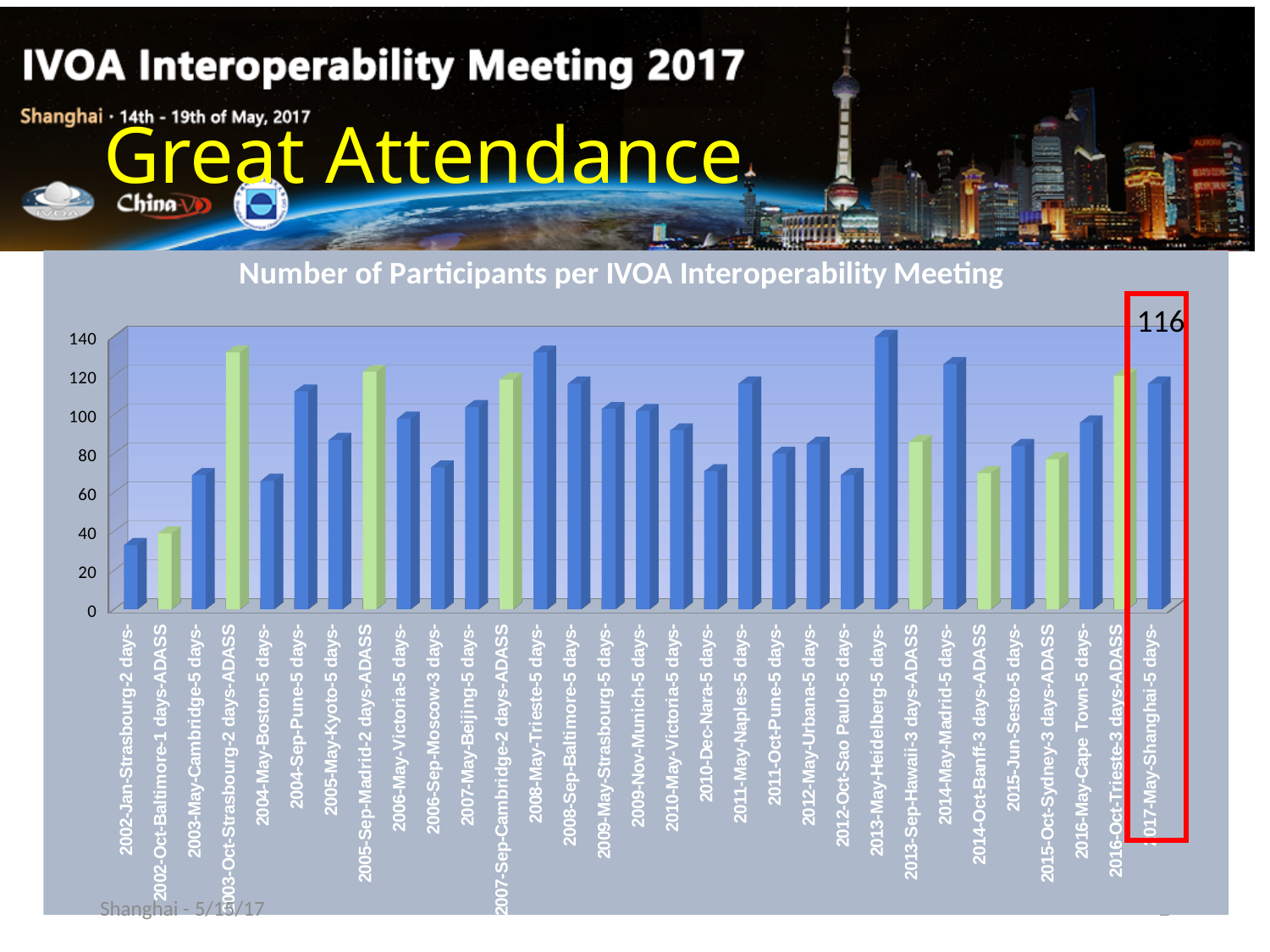
How many meetings are plotted on the chart? 31 Which meeting has the lowest number of participants? 2002-Jan-Strasbourg-2 days What is the number of participants shown for the 2017-May-Shanghai-5 days meeting? 116 Is the value for 2002-Jan-Strasbourg-2 days greater or less than 40? less What is the title of the chart? Number of Participants per IVOA Interoperability Meeting What kind of chart is shown on the slide? Bar chart Which meeting has the highest number of participants? 2013-May-Heidelberg-5 days Is the value for 2003-Oct-Strasbourg-2 days-ADASS greater or less than 120? greater Which has more participants, 2008-May-Trieste-5 days or 2008-Sep-Baltimore-5 days? 2008-May-Trieste-5 days Is the value for 2013-May-Heidelberg-5 days greater or less than 120? greater Which has more participants, 2014-May-Madrid-5 days or 2014-Oct-Banff-3 days-ADASS? 2014-May-Madrid-5 days